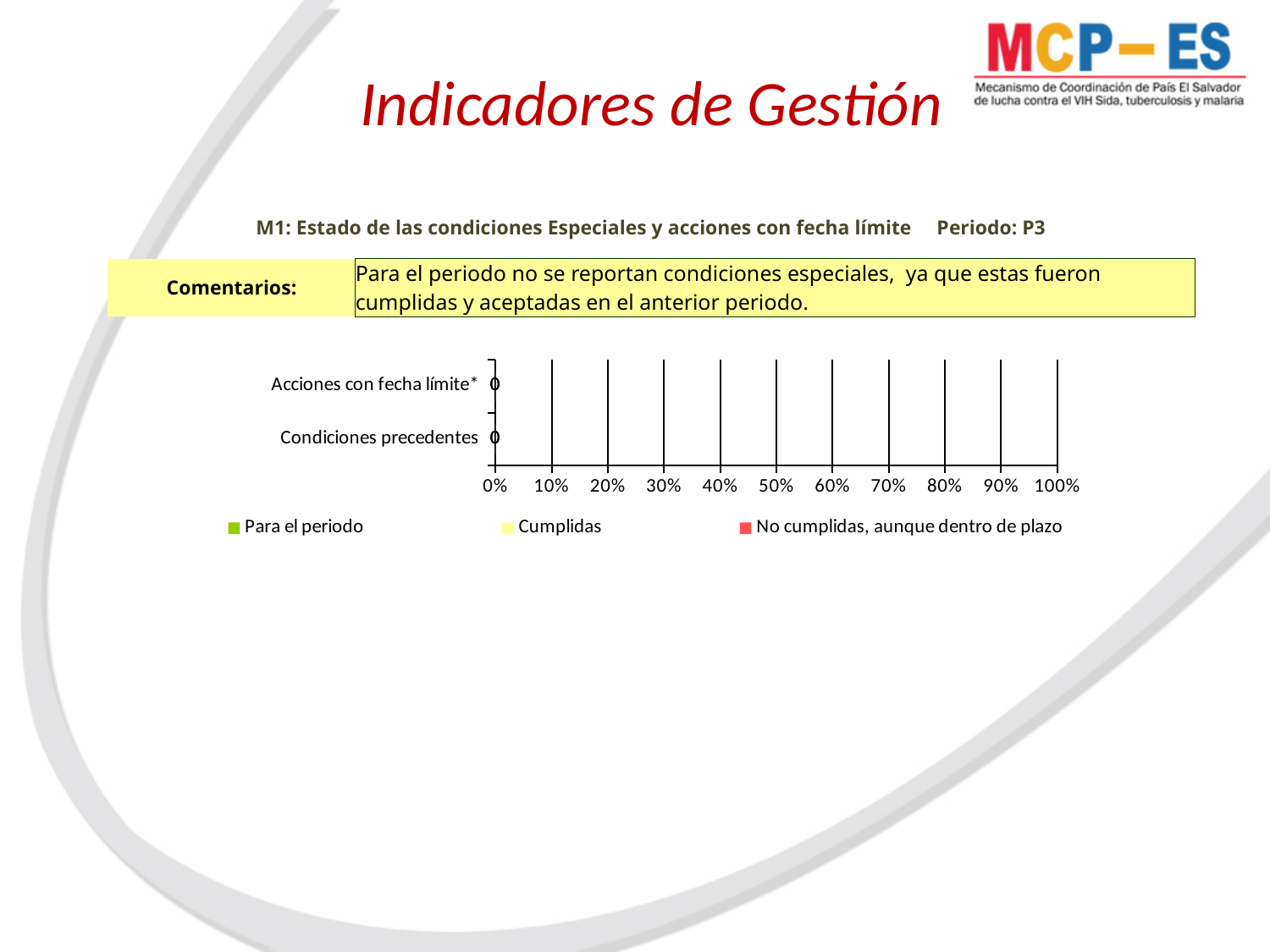
What value is shown for "Acciones con fecha límite*"? 0 What is the highest value shown on the horizontal axis of the chart? 100% How many series does the chart legend list? 3 What kind of chart is shown on the slide? bar chart Is the value for "Condiciones precedentes" greater or less than 50%? less Is the value for "Acciones con fecha límite*" greater or less than 10%? less Which legend entry is shown in red? No cumplidas, aunque dentro de plazo What value is shown for "Condiciones precedentes"? 0 How many categories are listed on the vertical axis of the chart? 2